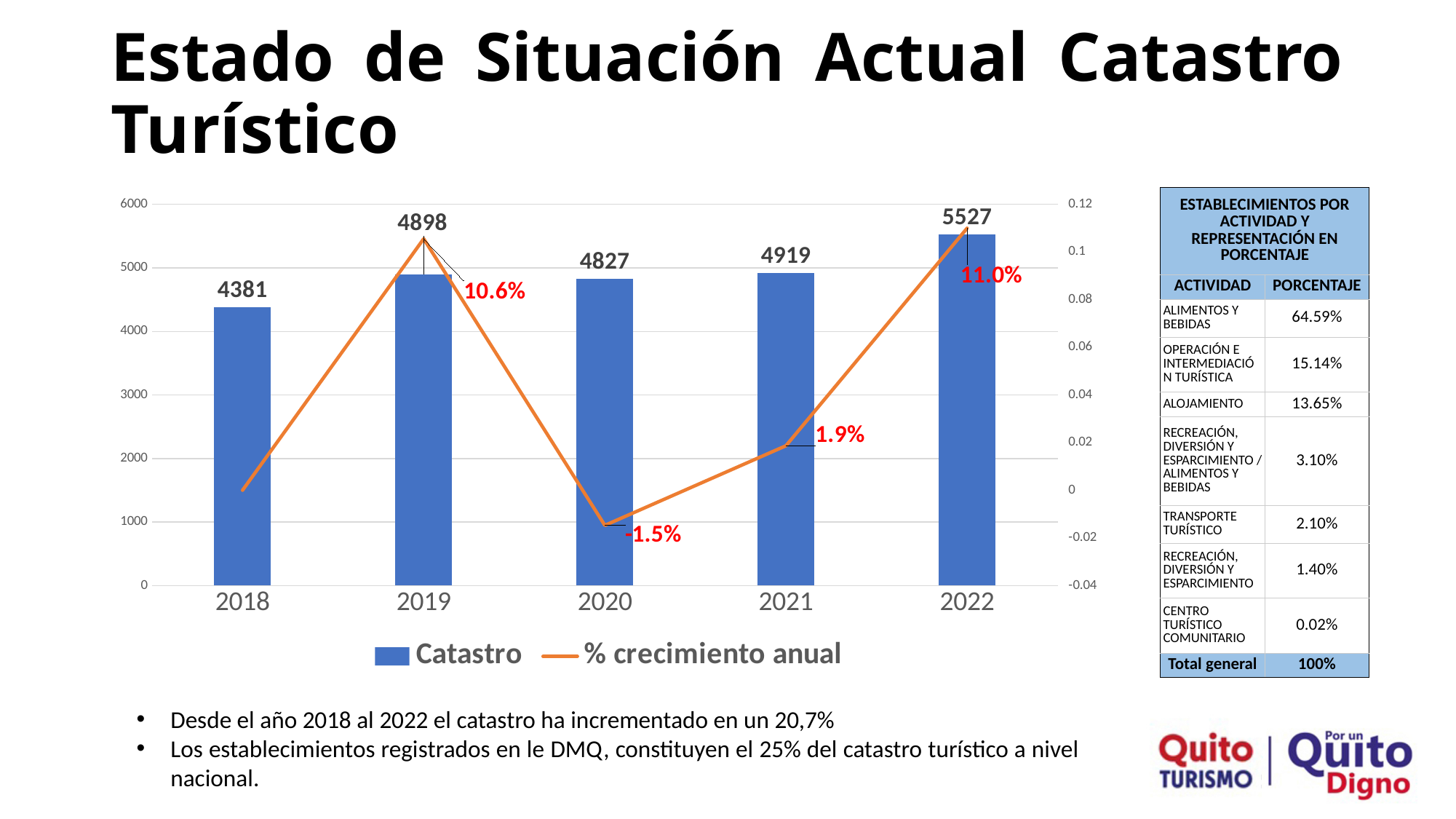
What is the Catastro value for 2022? 5527 Which is larger, the Catastro value for 2019 or for 2020? 2019 How many years are shown on the x axis of the chart? 5 Which year has the lowest Catastro value? 2018 Is the Catastro value for 2021 greater or less than 5000? less Which year has the highest Catastro value? 2022 What is the % crecimiento anual value for 2020? -1.5% What is the Catastro value for 2018? 4381 What is the difference between the Catastro values for 2022 and 2018? 1146 What is the % crecimiento anual value for 2021? 1.9% How many series does the chart legend list? 2 Which series is drawn as an orange line in the chart? % crecimiento anual